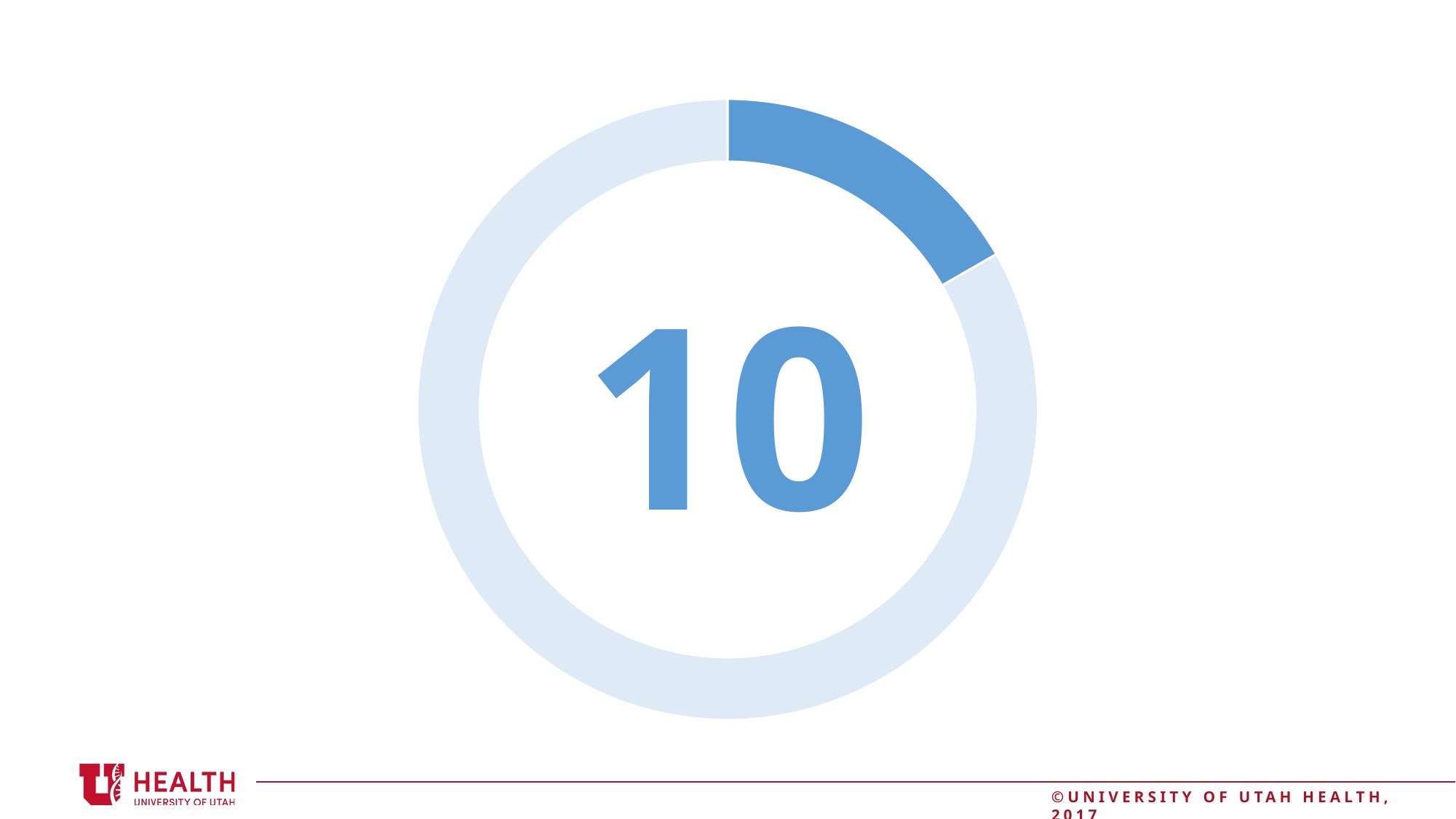
How many segments does the doughnut chart have? 2 What kind of chart is shown on the slide? Doughnut chart What number is displayed in the centre of the doughnut chart? 10 Which segment of the doughnut chart is larger, the dark blue one or the light blue one? The light blue one Does the doughnut chart display a legend? No